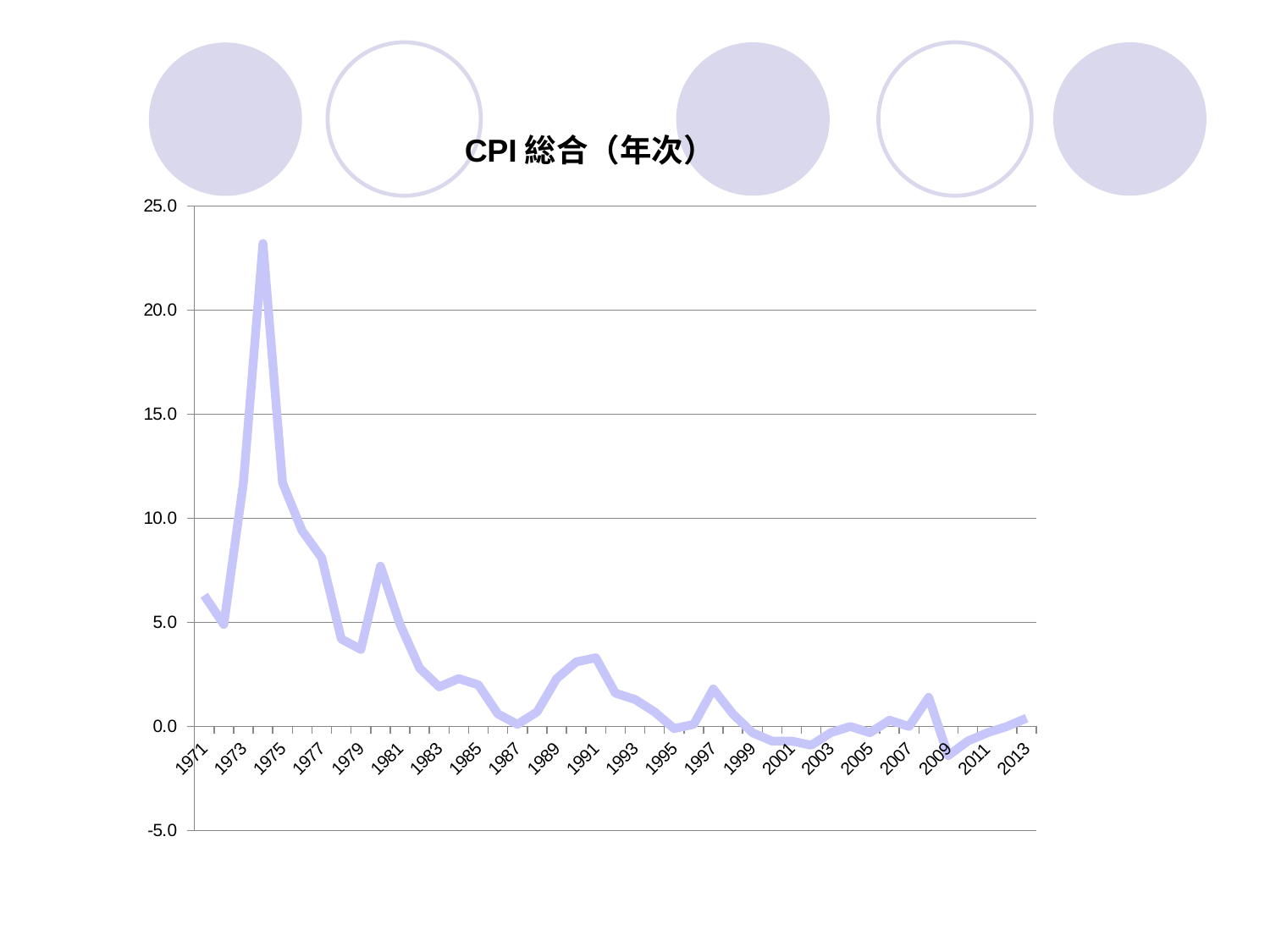
In which year does the CPI line reach its highest value? 1974 Which year has the larger value, 1971 or 1997? 1971 What is the highest value shown on the vertical axis? 25.0 Is the value for 1975 greater or less than 10.0? greater What kind of chart is shown on the slide? line chart Is the value for 1980 greater or less than 5.0? greater Which year has the larger value, 1974 or 1980? 1974 Is the value for 1974 greater or less than 20.0? greater Does the line generally rise or fall from 1974 to 1978? fall What is the title of the chart? CPI 総合（年次）